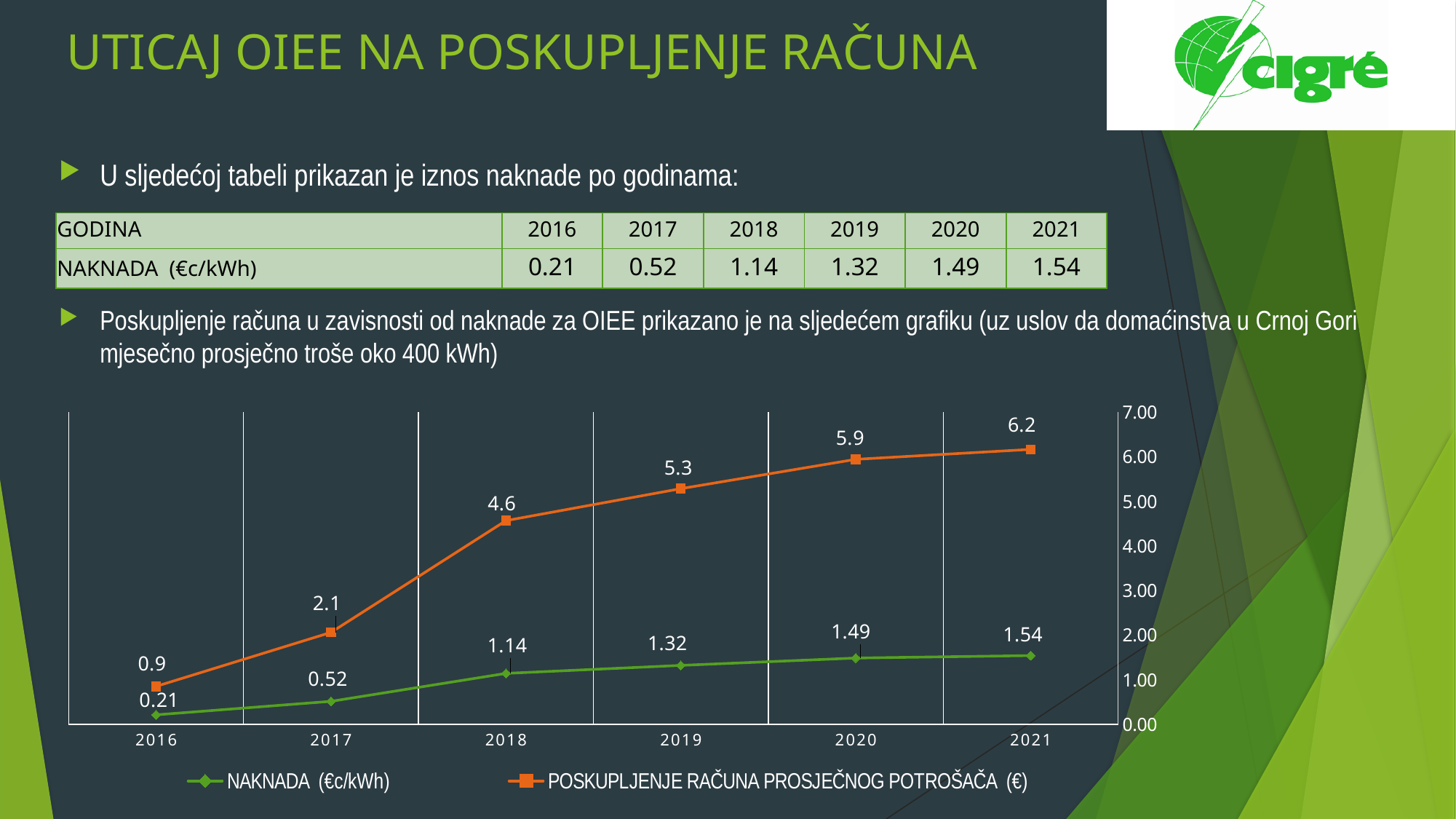
What is the value of POSKUPLJENJE RAČUNA PROSJEČNOG POTROŠAČA (€) for 2016? 0.9 How many years are shown on the x axis of the chart? 6 What is the value of NAKNADA (€c/kWh) for 2019? 1.32 What is the difference between the NAKNADA (€c/kWh) values for 2018 and 2017? 0.62 Is the value of POSKUPLJENJE RAČUNA PROSJEČNOG POTROŠAČA (€) for 2019 greater or less than 5.00? greater What is the value of POSKUPLJENJE RAČUNA PROSJEČNOG POTROŠAČA (€) for 2018? 4.6 What is the difference between the POSKUPLJENJE RAČUNA PROSJEČNOG POTROŠAČA (€) values for 2021 and 2016? 5.3 In which year is POSKUPLJENJE RAČUNA PROSJEČNOG POTROŠAČA (€) highest? 2021 Which is larger: POSKUPLJENJE RAČUNA PROSJEČNOG POTROŠAČA (€) in 2017 or in 2018? 2018 In which year is NAKNADA (€c/kWh) lowest? 2016 What kind of chart is shown on the slide? line chart How many series does the chart legend list? 2